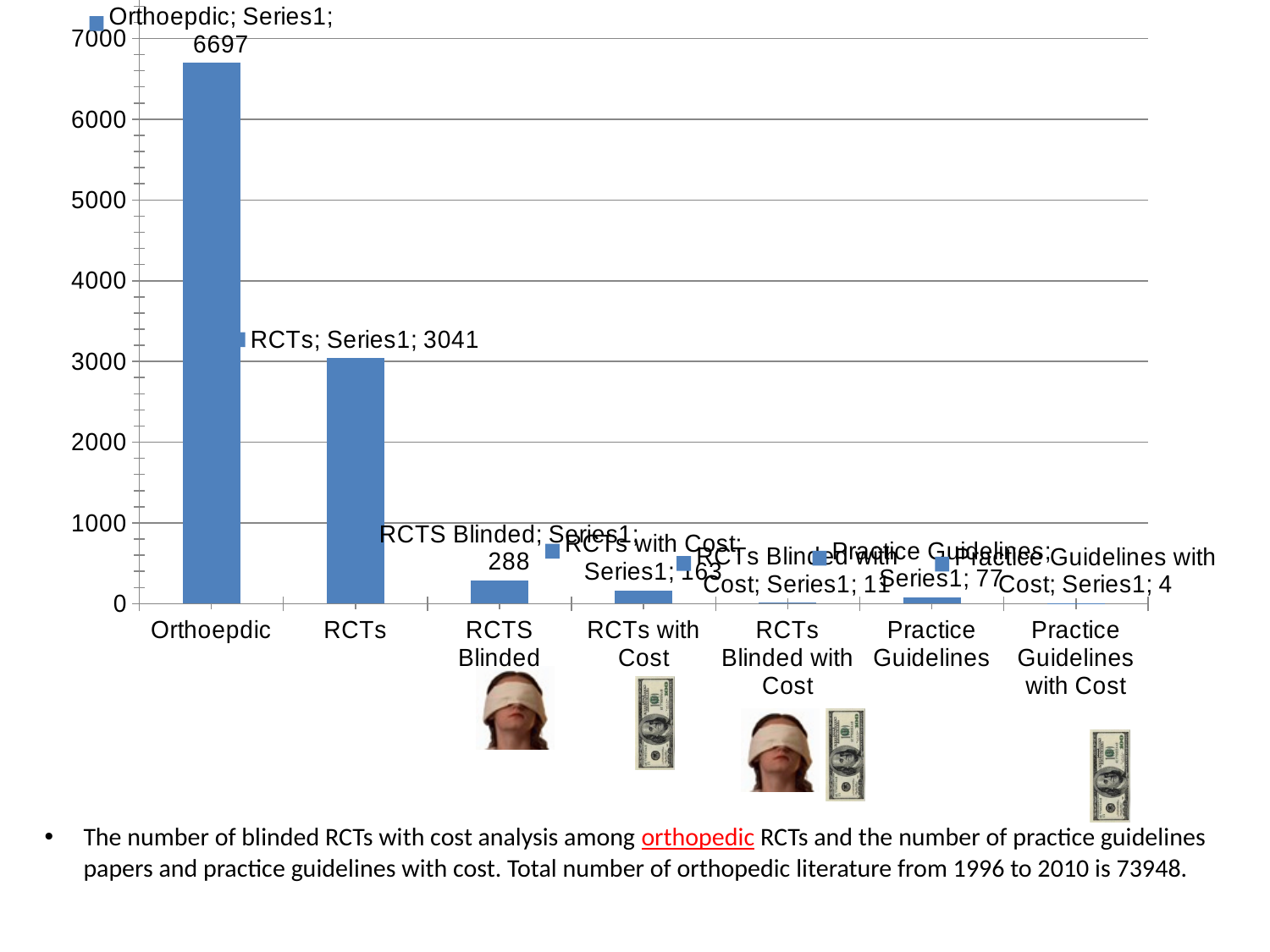
What is the difference between the values for Orthoepdic and RCTs? 3656 Is the value for RCTs greater or less than 4000? less What is the value for Practice Guidelines with Cost? 4 Which is larger, the value for RCTS Blinded or the value for Practice Guidelines? RCTS Blinded What is the value for Orthoepdic? 6697 What is the value for RCTs? 3041 What is the value for RCTs with Cost? 163 Which category has the lowest value? Practice Guidelines with Cost What is the value for RCTS Blinded? 288 What is the value for Practice Guidelines? 77 Which category has the highest value? Orthoepdic How many categories are shown on the x axis? 7